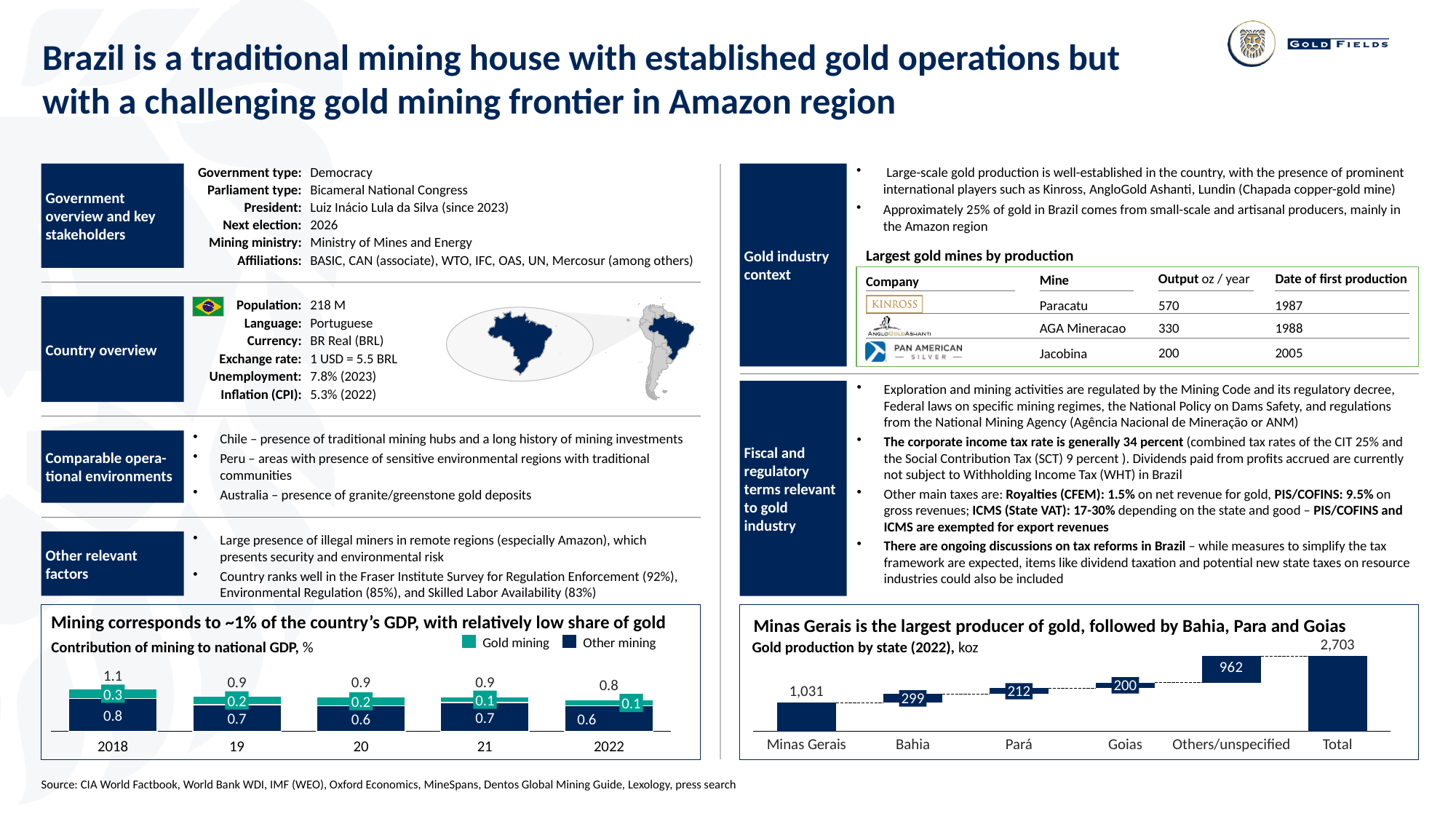
In the 'Contribution of mining to national GDP' chart, which year has the highest total contribution of mining to GDP? 2018 In the 'Gold production by state (2022)' chart, what is the total gold production? 2,703 In the 'Contribution of mining to national GDP' chart, what is the value for other mining in 2019? 0.7 In the 'Contribution of mining to national GDP' chart, what is the value for gold mining in 2022? 0.1 In the 'Gold production by state (2022)' chart, which named state has the lowest gold production? Goias In the 'Contribution of mining to national GDP' chart, what is the total contribution of mining to GDP in 2018? 1.1 In the 'Gold production by state (2022)' chart, which is larger, the gold production of Minas Gerais or Others/unspecified? Minas Gerais In the 'Contribution of mining to national GDP' chart, does the total contribution of mining to GDP rise or fall from 2018 to 2022? fall In the 'Contribution of mining to national GDP' chart, what is the difference between the gold mining values for 2018 and 2022? 0.2 In the 'Gold production by state (2022)' chart, what is the difference between the gold production of Bahia and Pará? 87 In the 'Gold production by state (2022)' chart, what is the gold production for Minas Gerais? 1,031 In the 'Contribution of mining to national GDP' chart, how many series does the legend list? 2